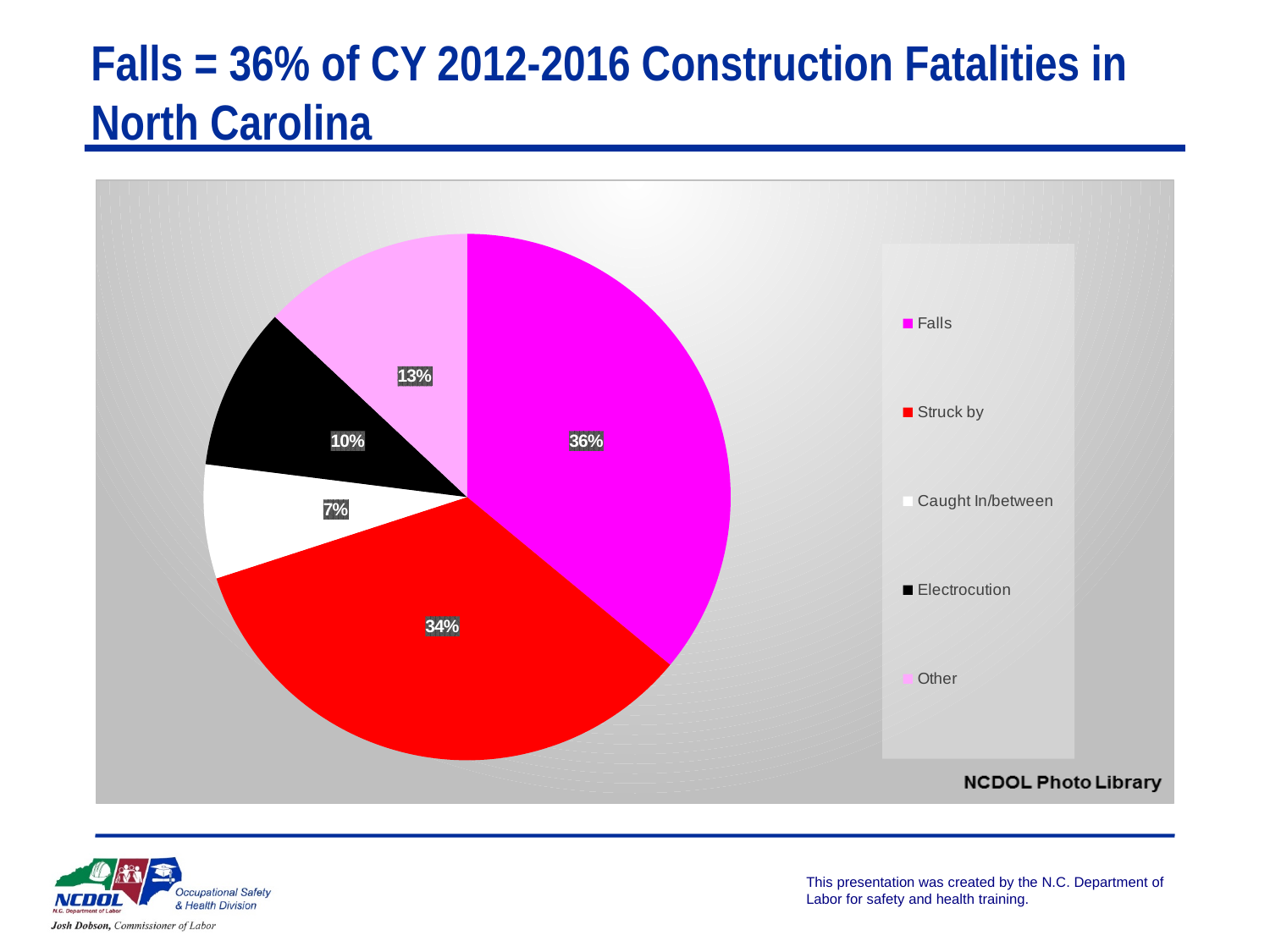
What percentage of construction fatalities is attributed to Electrocution? 10% What is the difference in percentage points between Falls and Struck by? 2% What percentage of construction fatalities is attributed to Other? 13% Which category has the smallest share of construction fatalities? Caught In/between What percentage of construction fatalities is attributed to Caught In/between? 7% What percentage of construction fatalities is attributed to Falls? 36% How many categories does the pie chart show? 5 Which category has the largest share of construction fatalities? Falls What colour is the Struck by slice in the pie chart? red What type of chart is shown on the slide? pie chart Which is larger, the share for Electrocution or the share for Other? Other What percentage of construction fatalities is attributed to Struck by? 34%